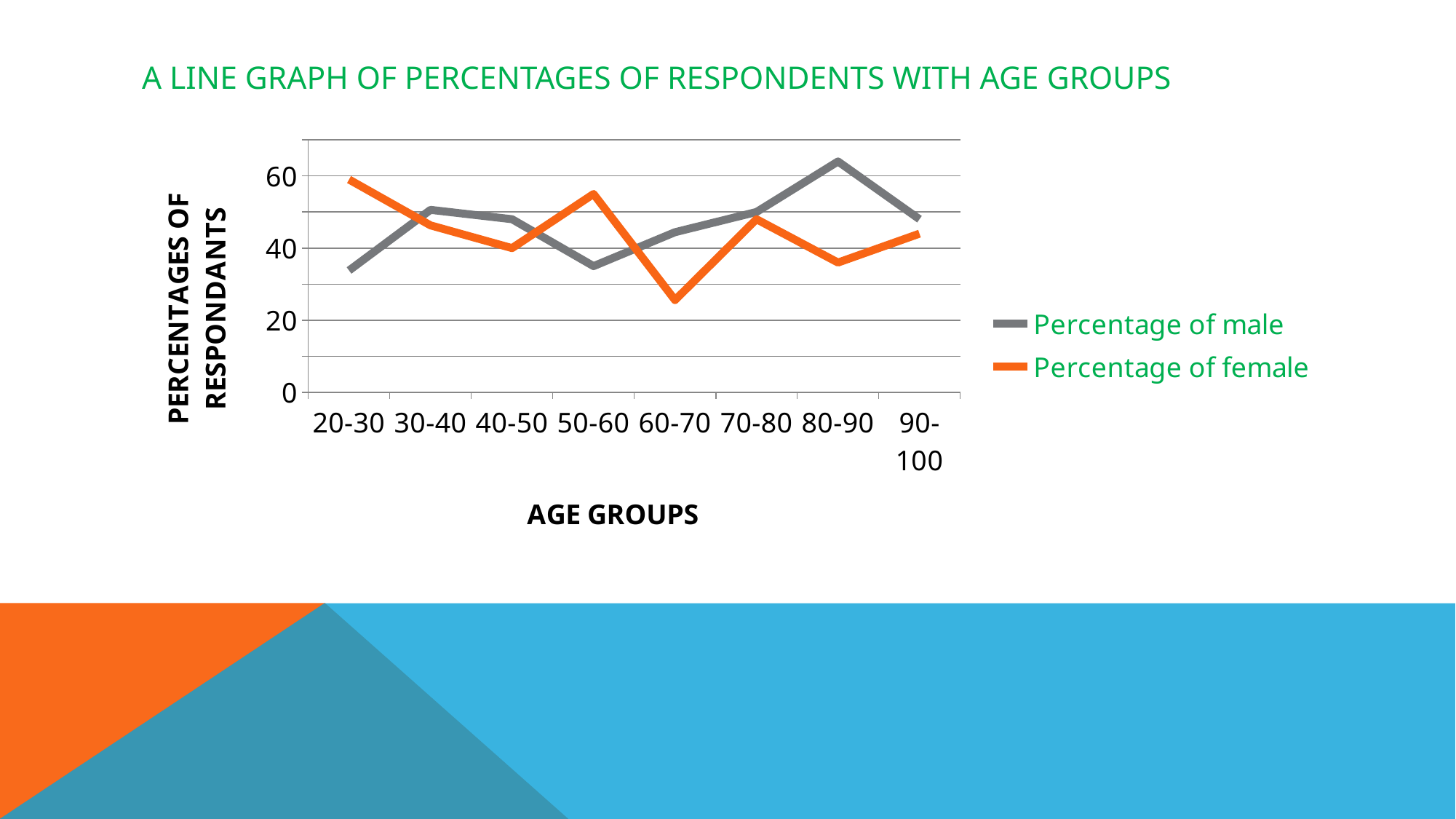
How many series does the legend list? 2 For the 80-90 age group, which is larger: Percentage of male or Percentage of female? Percentage of male Is the Percentage of female for the 60-70 age group greater or less than 40? less Is the Percentage of female for the 20-30 age group greater or less than 40? greater Does the Percentage of male rise or fall from the 50-60 age group to the 80-90 age group? rise What kind of chart is shown on the slide? line chart Which age group has the highest Percentage of male? 80-90 Which age group has the lowest Percentage of female? 60-70 For the 20-30 age group, which is larger: Percentage of male or Percentage of female? Percentage of female Is the Percentage of male for the 80-90 age group greater or less than 60? greater What colour is the line for Percentage of female? orange How many age groups are plotted on the x axis? 8